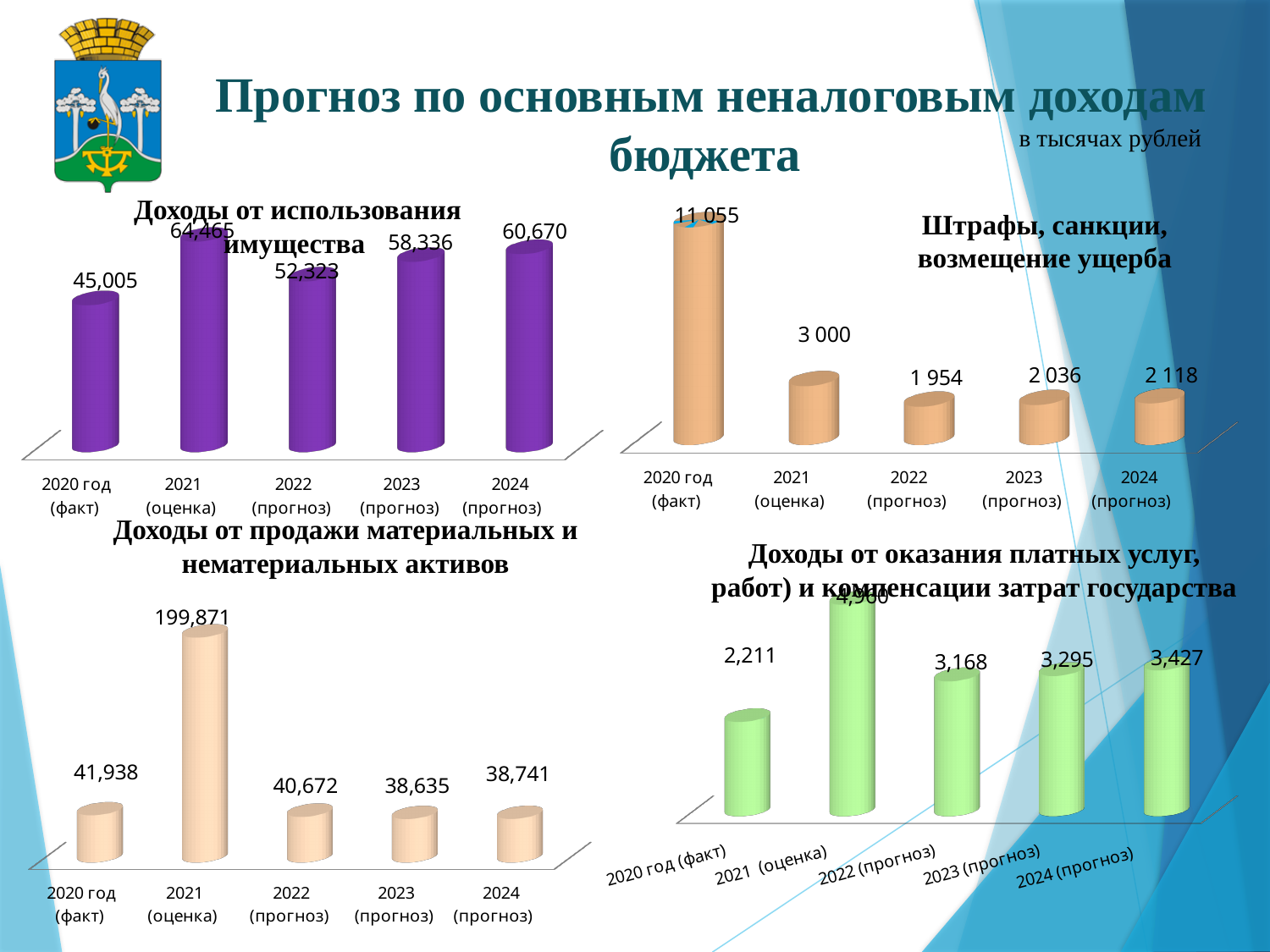
In the chart 'Доходы от продажи материальных и нематериальных активов', is the value for 2020 год (факт) larger or smaller than the value for 2022 (прогноз)? larger In the chart 'Доходы от продажи материальных и нематериальных активов', what is the value for 2021 (оценка)? 199,871 In the chart 'Штрафы, санкции, возмещение ущерба', which year has the lowest value? 2022 (прогноз) In the chart 'Доходы от продажи материальных и нематериальных активов', which year has the lowest value? 2023 (прогноз) In the chart 'Доходы от оказания платных услуг, работ) и компенсации затрат государства', what is the difference between the 2023 (прогноз) and 2022 (прогноз) values? 127 In the chart 'Доходы от оказания платных услуг, работ) и компенсации затрат государства', what is the value for 2024 (прогноз)? 3,427 In the chart 'Доходы от использования имущества', what is the difference between the 2024 (прогноз) and 2023 (прогноз) values? 2,334 In the chart 'Доходы от использования имущества', which year has the highest value? 2021 (оценка) In the chart 'Доходы от использования имущества', what is the value for 2020 год (факт)? 45,005 In the chart 'Штрафы, санкции, возмещение ущерба', what is the value for 2024 (прогноз)? 2 118 In the chart 'Штрафы, санкции, возмещение ущерба', what is the value for 2020 год (факт)? 11 055 How many charts are shown on the slide? 4